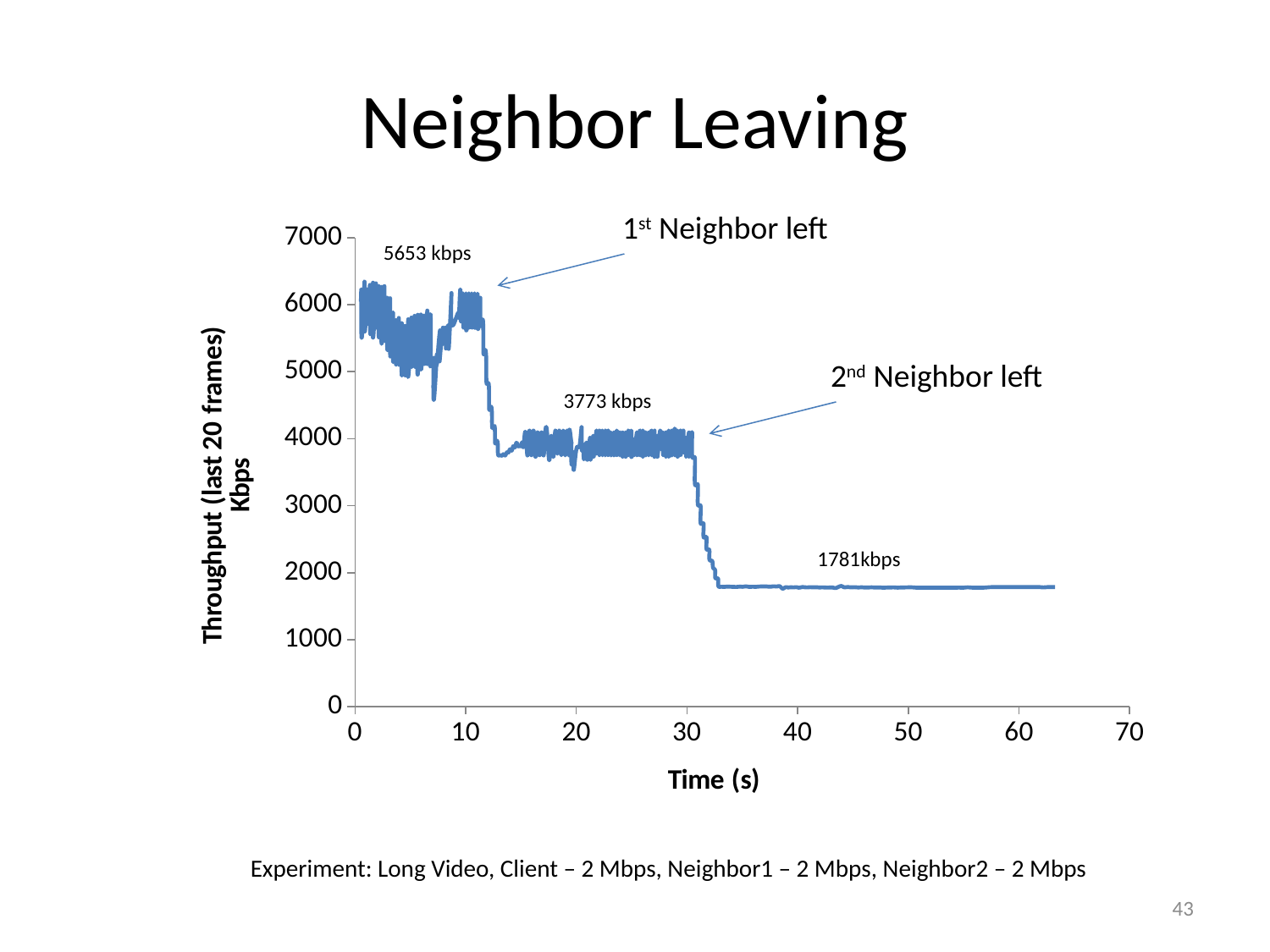
What is the throughput label shown for the first plateau, before the 1st neighbor left? 5653 kbps What kind of chart is shown on the slide? line chart What is the difference between the labelled throughput of the middle plateau (3773 kbps) and the final plateau (1781 kbps)? 1992 kbps What event does the second arrow annotation on the chart mark? 2nd Neighbor left What is the difference between the labelled throughput of the first plateau (5653 kbps) and the middle plateau (3773 kbps)? 1880 kbps What is the throughput label shown for the final plateau, after the 2nd neighbor left? 1781kbps Does the throughput generally rise or fall as time increases along the x axis? fall What is the label of the x axis? Time (s) Which labelled plateau has the higher throughput, the one at 3773 kbps or the one at 1781 kbps? 3773 kbps Is the throughput at 20 seconds greater or less than 3000? greater Is the throughput at 50 seconds greater or less than 2000? less What is the throughput label shown for the middle plateau, between the 1st and 2nd neighbor leaving? 3773 kbps